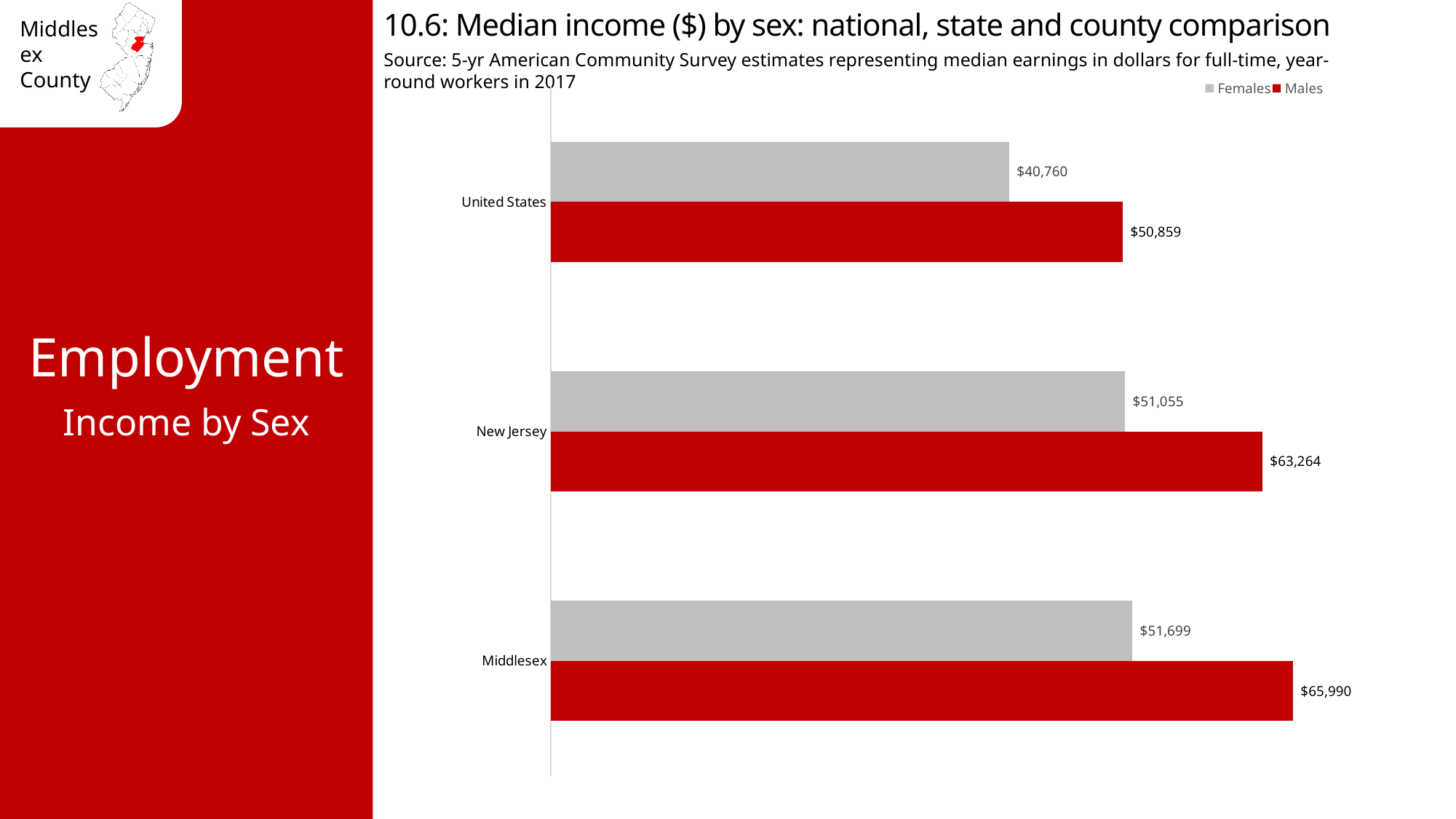
What is the median income for females in the United States? $40,760 What is the median income for females in Middlesex? $51,699 What is the median income for males in New Jersey? $63,264 How many series does the legend list? 2 What is the difference between male and female median income in Middlesex? $14,291 Which geography has the lowest median income for females? United States What is the difference between male and female median income in the United States? $10,099 Which geography has the highest median income for males? Middlesex How many geographies are shown on the chart? 3 What is the median income for males in Middlesex? $65,990 Which is larger: the female median income in New Jersey or the male median income in the United States? Female median income in New Jersey What type of chart is shown on the slide? Bar chart